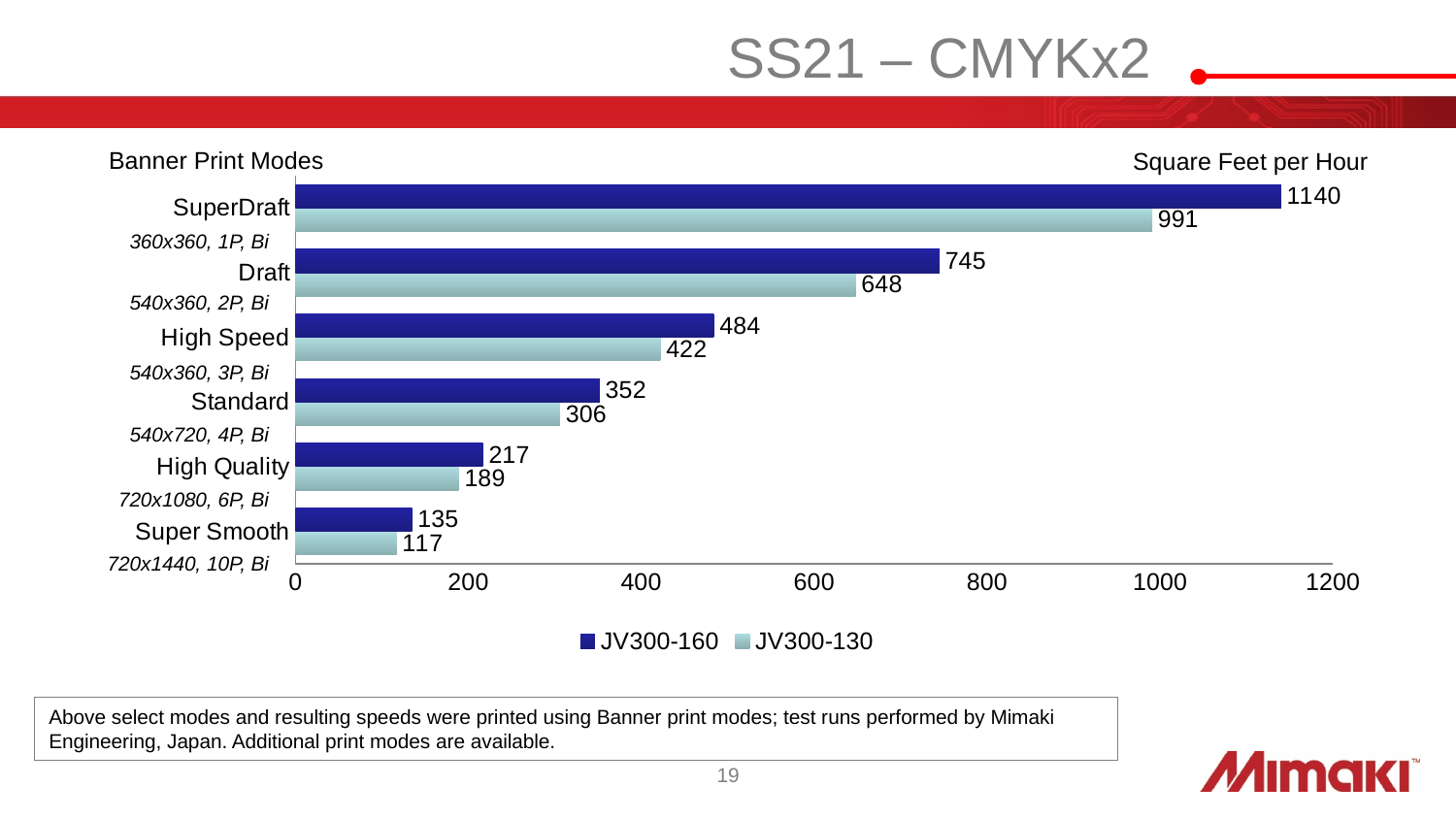
Which print mode has the highest JV300-130 value? SuperDraft Which is larger for High Quality, the JV300-160 value or the JV300-130 value? JV300-160 What kind of chart is shown on the slide? bar chart How many series does the legend list? 2 Is the JV300-130 value for Standard greater or less than 400? less What is the difference between the JV300-160 and JV300-130 values for Draft? 97 Which print mode has the lowest JV300-160 value? Super Smooth What is the JV300-160 value for SuperDraft? 1140 What is the difference between the JV300-160 values for Standard and High Quality? 135 How many print modes are shown on the chart? 6 What is the JV300-160 value for Super Smooth? 135 What is the JV300-130 value for High Speed? 422